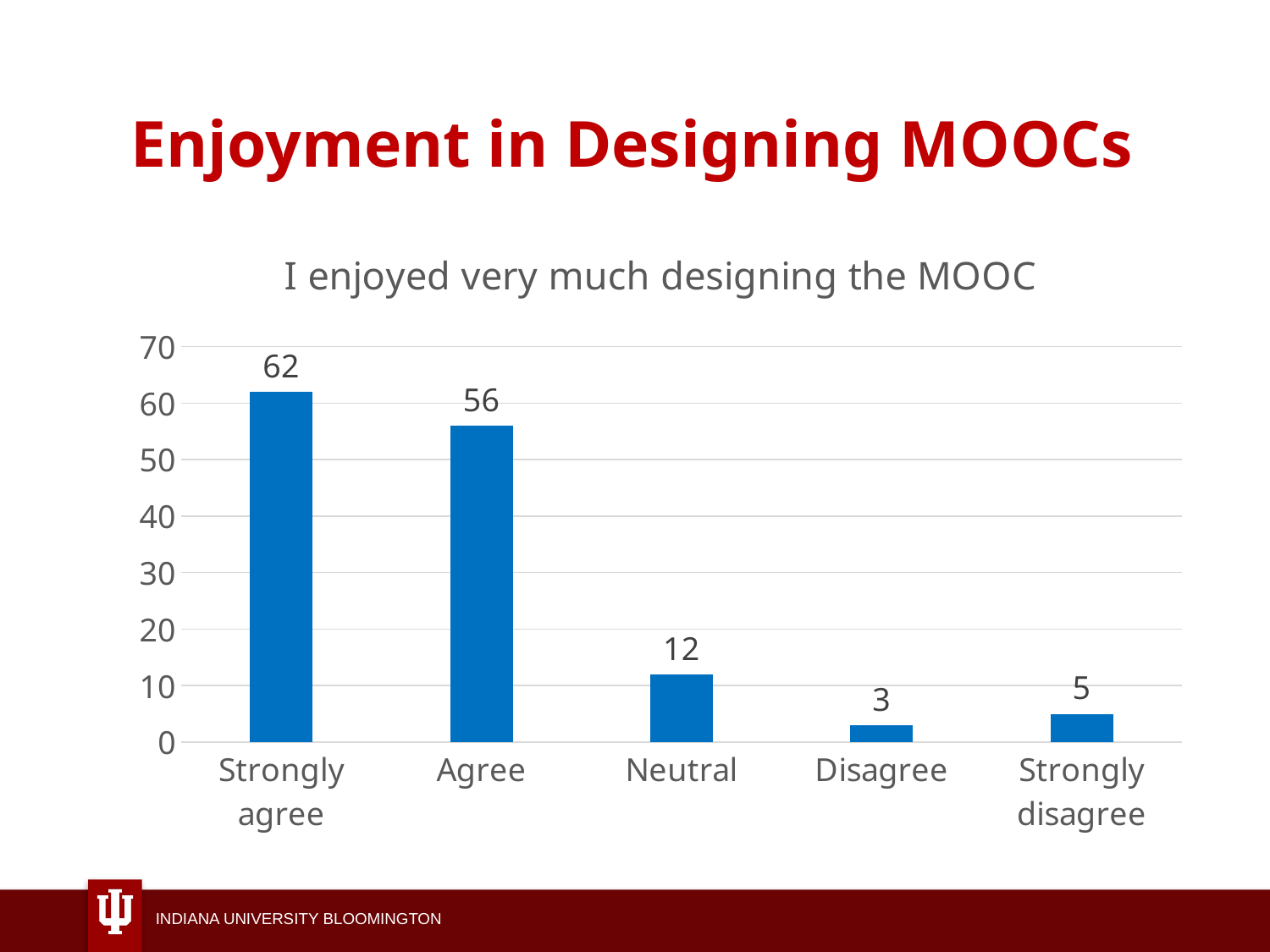
What is the difference between the values for Strongly agree and Agree? 6 Is the value for Agree greater or less than 50? greater What kind of chart is shown on the slide? bar chart What is the value for Neutral? 12 What is the title of the chart? I enjoyed very much designing the MOOC Which category has the highest value? Strongly agree What is the difference between the values for Neutral and Strongly disagree? 7 Which is larger, the value for Agree or the value for Neutral? Agree How many categories are shown on the x axis? 5 What is the value for Strongly agree? 62 What is the value for Disagree? 3 Which category has the lowest value? Disagree